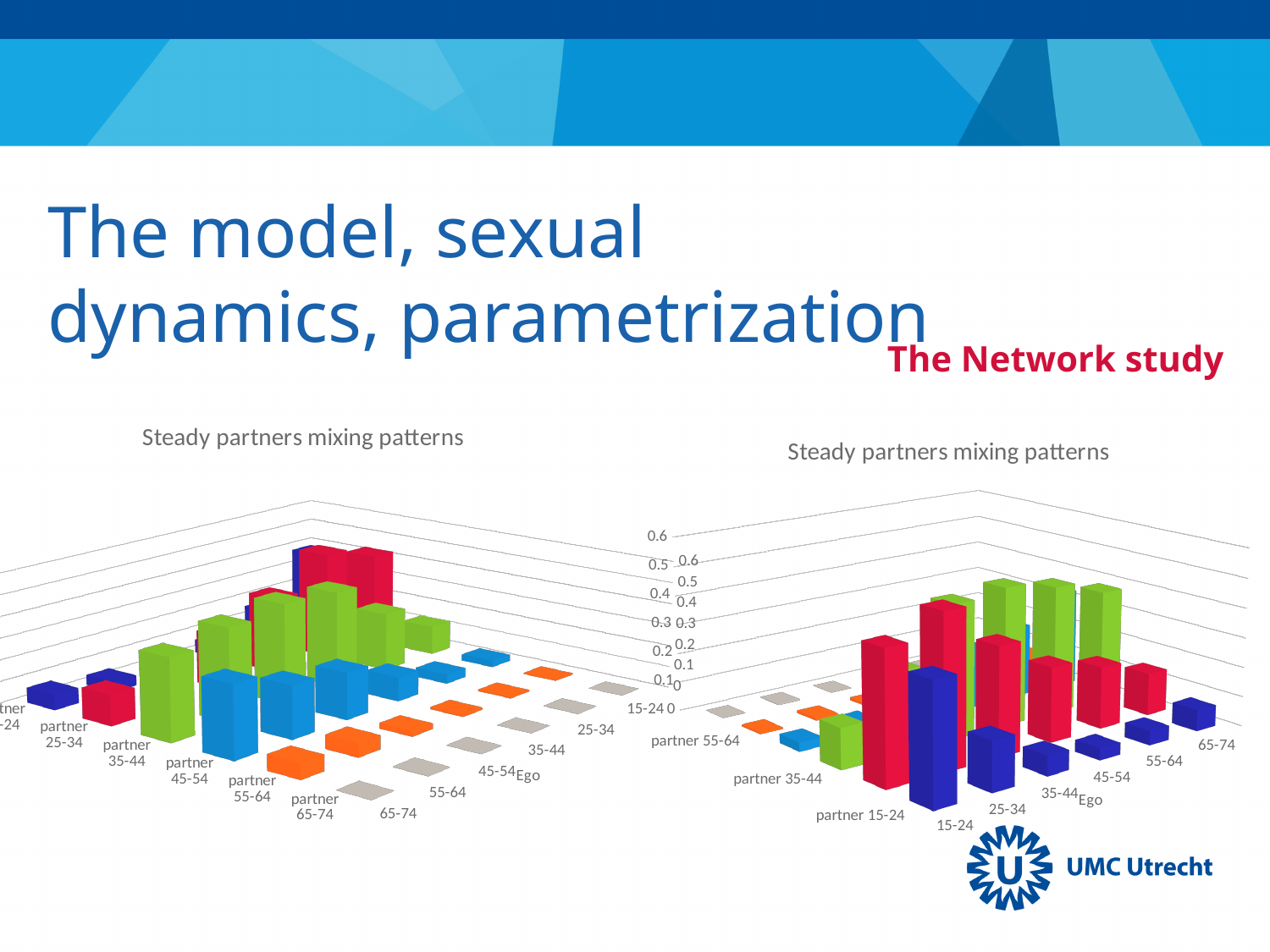
What is the title of the right chart? Steady partners mixing patterns In the left chart, what is the highest value shown on the vertical axis? 0.6 In the right chart, how many Ego age categories are shown along the Ego axis? 6 In the left chart, how many Ego age categories are shown along the Ego axis? 6 What kind of chart is the left chart titled "Steady partners mixing patterns"? bar chart In the right chart, is the value for Ego 15-24 with partner 15-24 greater or less than 0.3? greater What kind of chart is the right chart on the slide? bar chart What is the title of the left chart? Steady partners mixing patterns